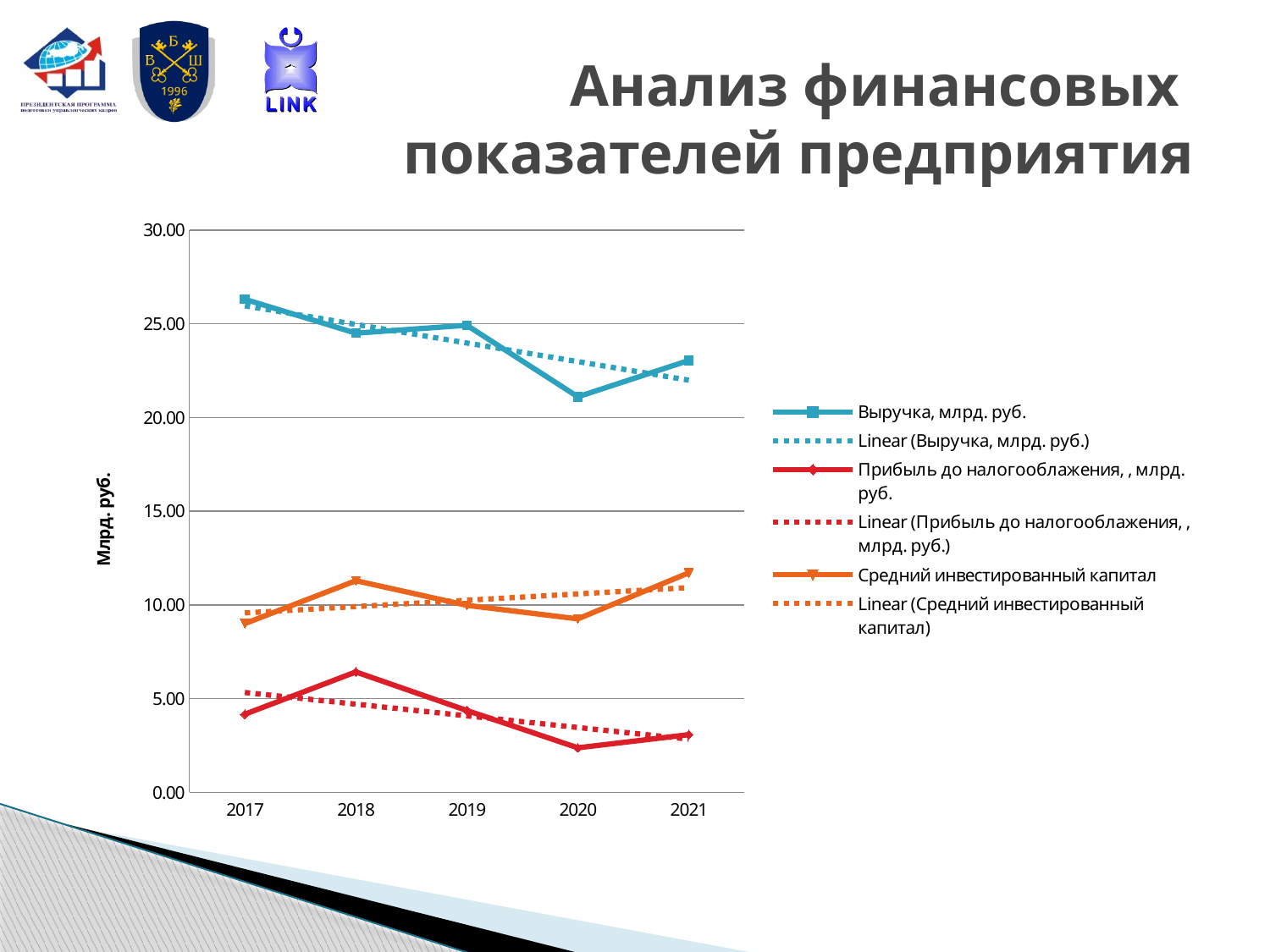
In which year is Прибыль до налогооблажения highest? 2018 In which year is Выручка, млрд. руб. highest? 2017 How many years are plotted along the x axis? 5 Is the value for Выручка, млрд. руб. in 2017 greater or less than 25.00? greater Is the value for Средний инвестированный капитал in 2017 greater or less than 10.00? less What is the label on the vertical axis? Млрд. руб. Is the value for Прибыль до налогооблажения in 2018 greater or less than 5.00? greater Which is larger in 2021: Выручка, млрд. руб. or Средний инвестированный капитал? Выручка, млрд. руб. In which year is Выручка, млрд. руб. lowest? 2020 What kind of chart is shown on the slide? line chart How many entries does the legend list? 6 In which year is Прибыль до налогооблажения lowest? 2020